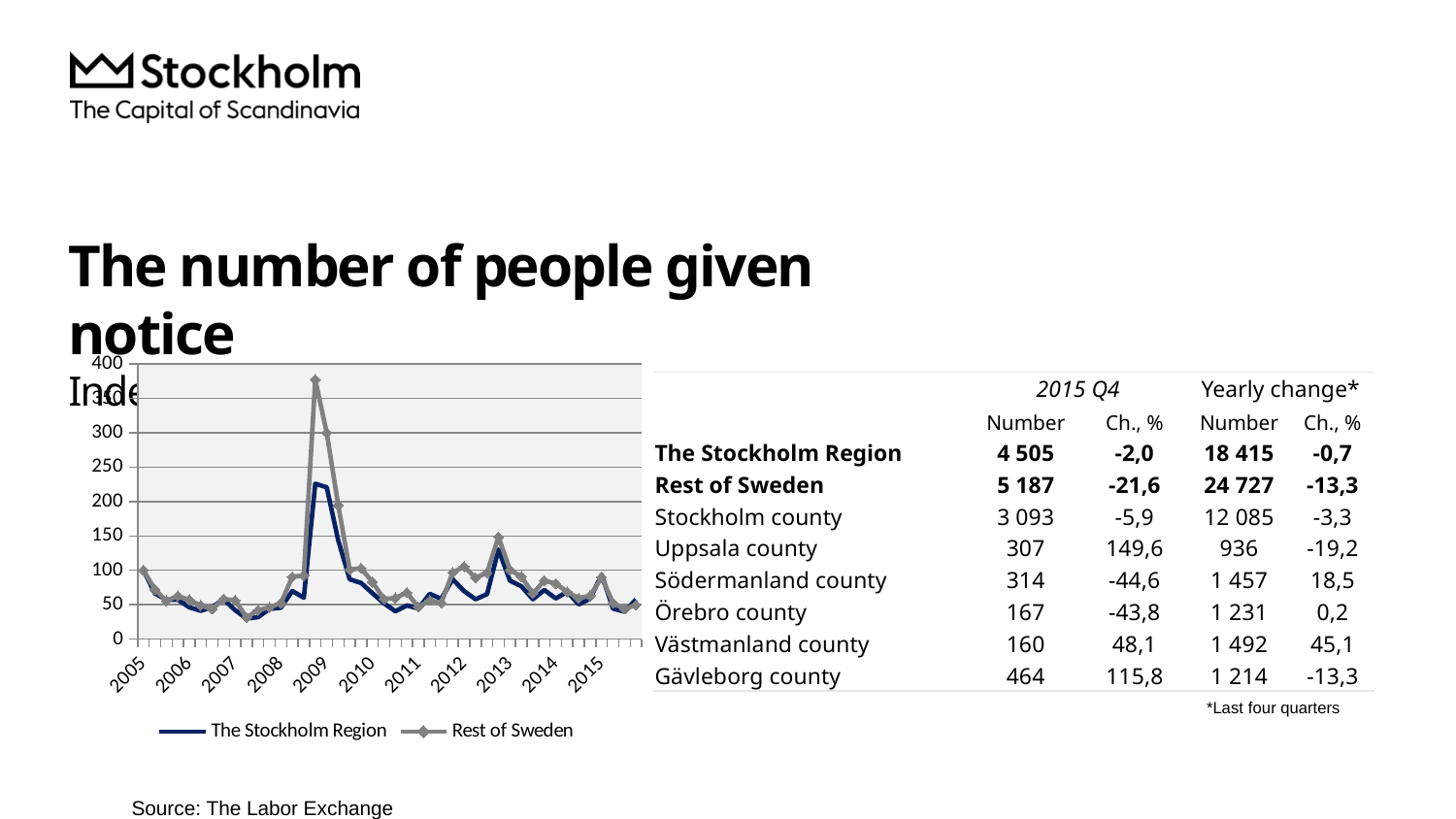
Which two series are listed in the chart's legend? The Stockholm Region and Rest of Sweden Is the peak value for The Stockholm Region in 2009 greater or less than 200? greater Do the values for both series rise or fall between the 2009 peak and 2010? fall Is the peak value for Rest of Sweden in 2009 greater or less than 350? greater How many series does the chart's legend list? 2 Is the peak value for The Stockholm Region in 2009 greater or less than 250? less What kind of chart is shown on the slide? line chart Which series reaches the highest peak in the chart? Rest of Sweden At the 2009 peak, which series has the larger value, The Stockholm Region or Rest of Sweden? Rest of Sweden What is the highest value shown on the y axis? 400 How many year labels are shown on the x axis? 11 In which year do both series reach their highest values? 2009